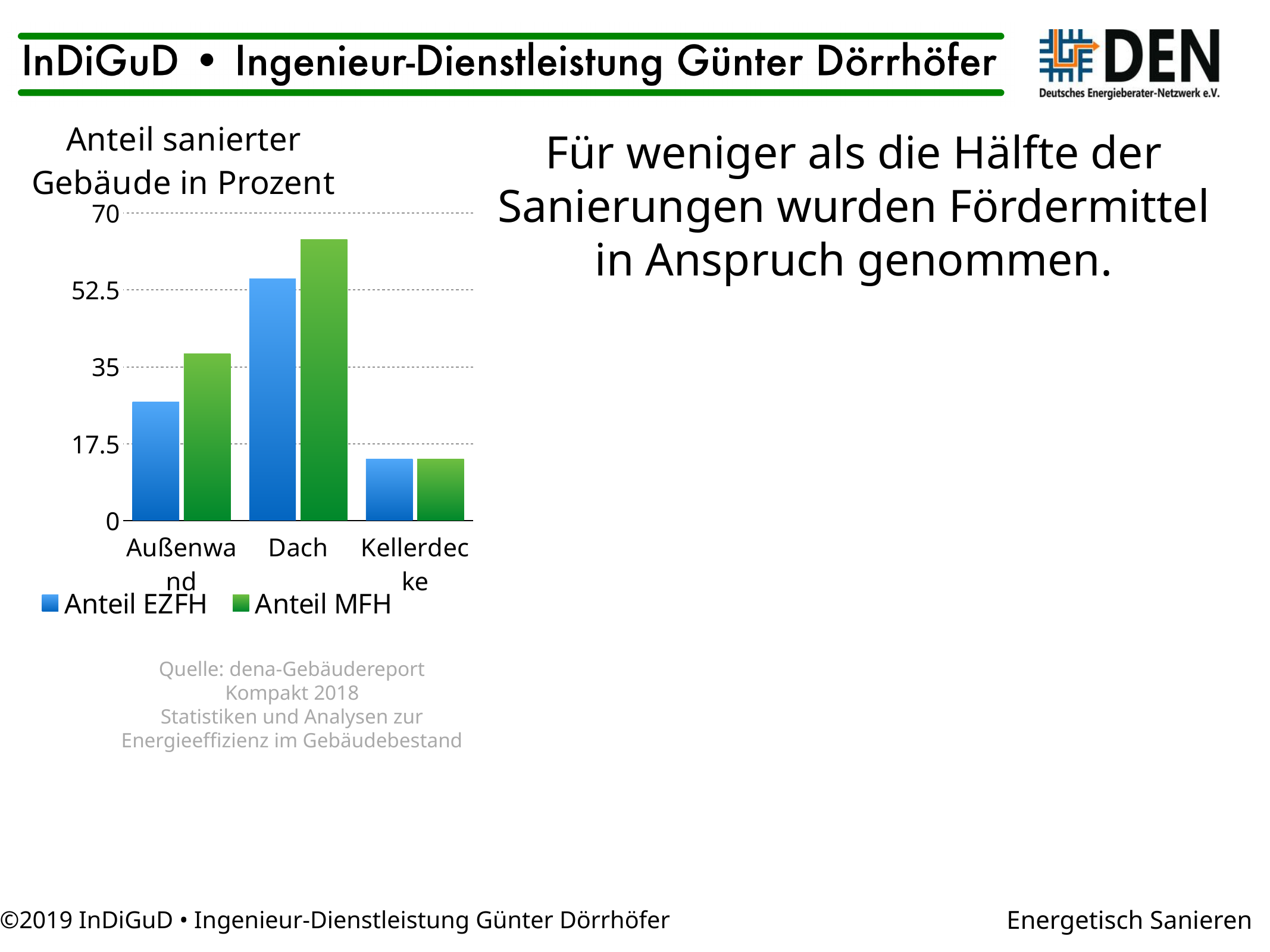
Is the value for Anteil EZFH at Außenwand greater or less than 35? less Which category has the highest value for Anteil EZFH? Dach How many categories are shown on the x axis of the chart? 3 How many series does the chart's legend list? 2 Which colour represents Anteil EZFH in the chart? blue What is the title of the chart? Anteil sanierter Gebäude in Prozent Is the value for Anteil EZFH at Kellerdecke greater or less than 17.5? less Which category has the lowest value for Anteil MFH? Kellerdecke For Außenwand, which series has the larger value, Anteil EZFH or Anteil MFH? Anteil MFH Is the value for Anteil MFH at Dach greater or less than 52.5? greater What kind of chart is shown on the slide? bar chart Which category has the highest value for Anteil MFH? Dach